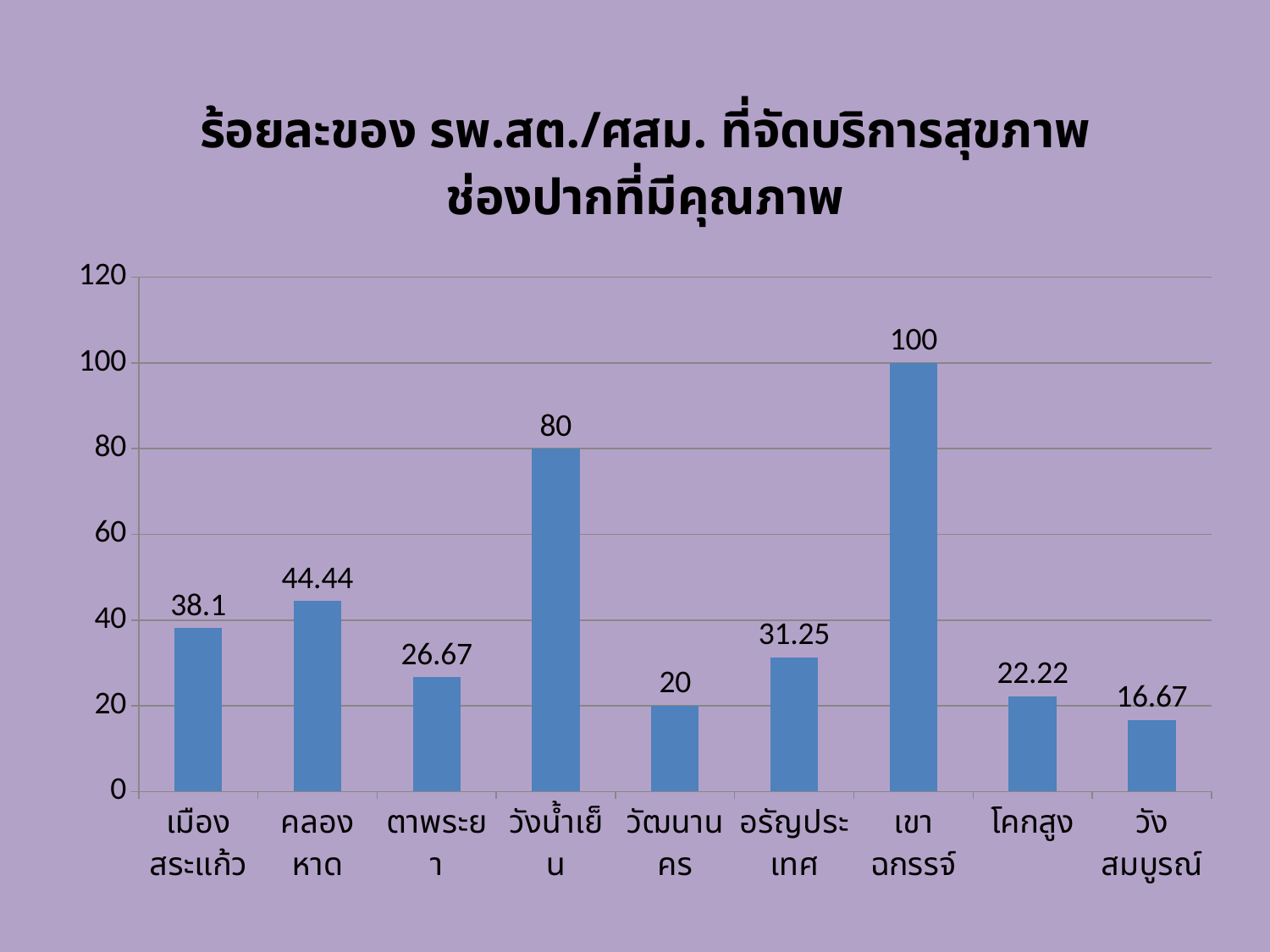
What is the difference between the values for เมืองสระแก้ว and ตาพระยา? 11.43 What is the value for วังสมบูรณ์? 16.67 Is the value for วังน้ำเย็น greater or less than 60? greater Which is larger, the value for อรัญประเทศ or the value for โคกสูง? อรัญประเทศ What kind of chart is shown on the slide? bar chart What is the difference between the values for เขาฉกรรจ์ and วังน้ำเย็น? 20 Which category has the lowest value? วังสมบูรณ์ What is the title of the chart? ร้อยละของ รพ.สต./ศสม. ที่จัดบริการสุขภาพช่องปากที่มีคุณภาพ Which category has the highest value? เขาฉกรรจ์ What is the value for คลองหาด? 44.44 How many categories are shown on the x axis? 9 What is the value for เขาฉกรรจ์? 100